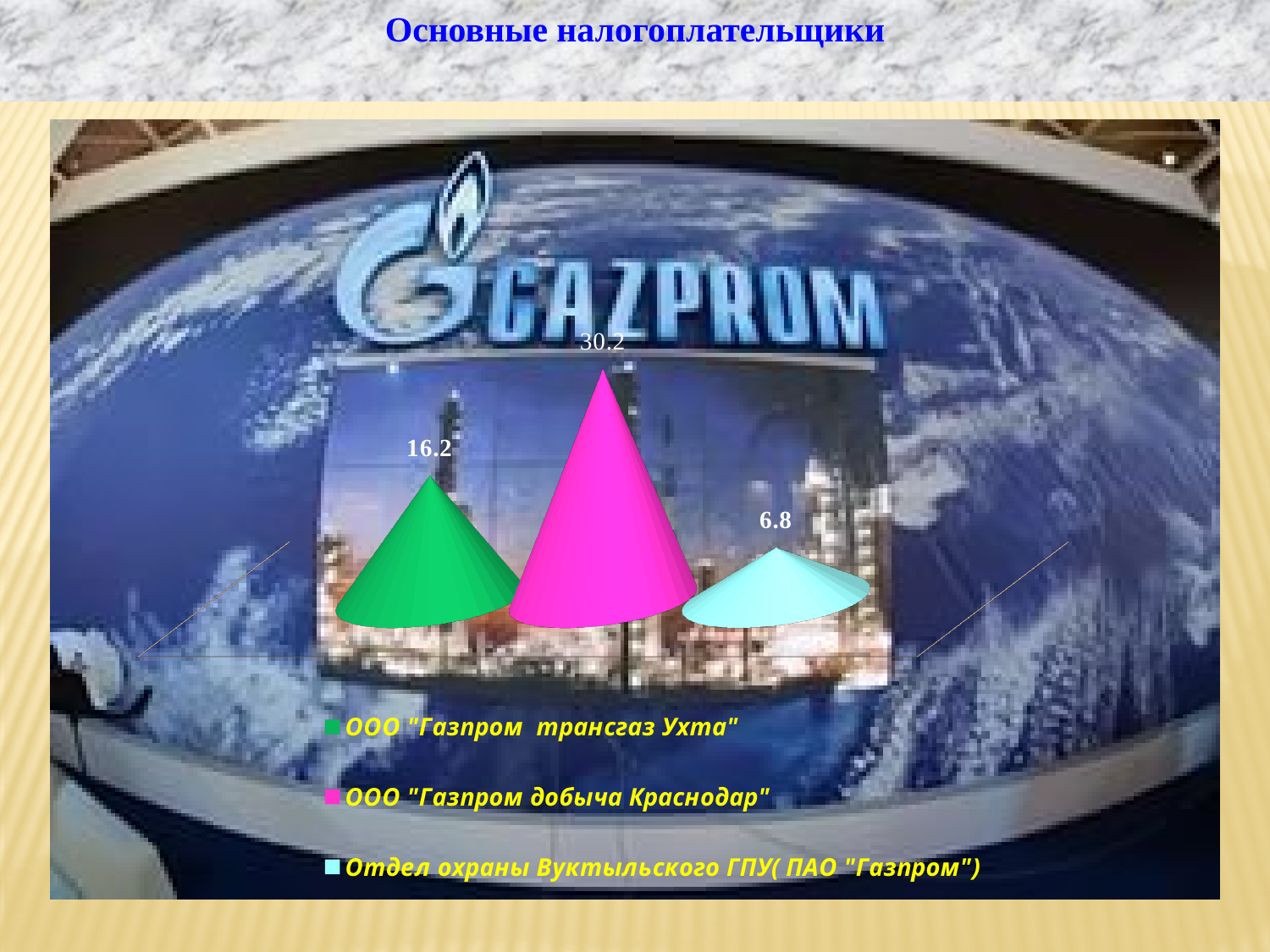
Which series has the highest value? ООО "Газпром добыча Краснодар" What kind of chart is shown on the slide? Bar chart Which series has the lowest value? Отдел охраны Вуктыльского ГПУ( ПАО "Газпром") What is the difference between the values for ООО "Газпром трансгаз Ухта" and Отдел охраны Вуктыльского ГПУ( ПАО "Газпром")? 9.4 How many data points are plotted on the chart? 3 What is the value for Отдел охраны Вуктыльского ГПУ( ПАО "Газпром")? 6.8 What is the difference between the values for ООО "Газпром добыча Краснодар" and ООО "Газпром трансгаз Ухта"? 14.0 What colour represents ООО "Газпром добыча Краснодар" in the chart? Pink What is the value for ООО "Газпром трансгаз Ухта"? 16.2 How many series does the legend list? 3 Which is larger, the value for ООО "Газпром трансгаз Ухта" or the value for Отдел охраны Вуктыльского ГПУ( ПАО "Газпром")? ООО "Газпром трансгаз Ухта" What is the value for ООО "Газпром добыча Краснодар"? 30.2